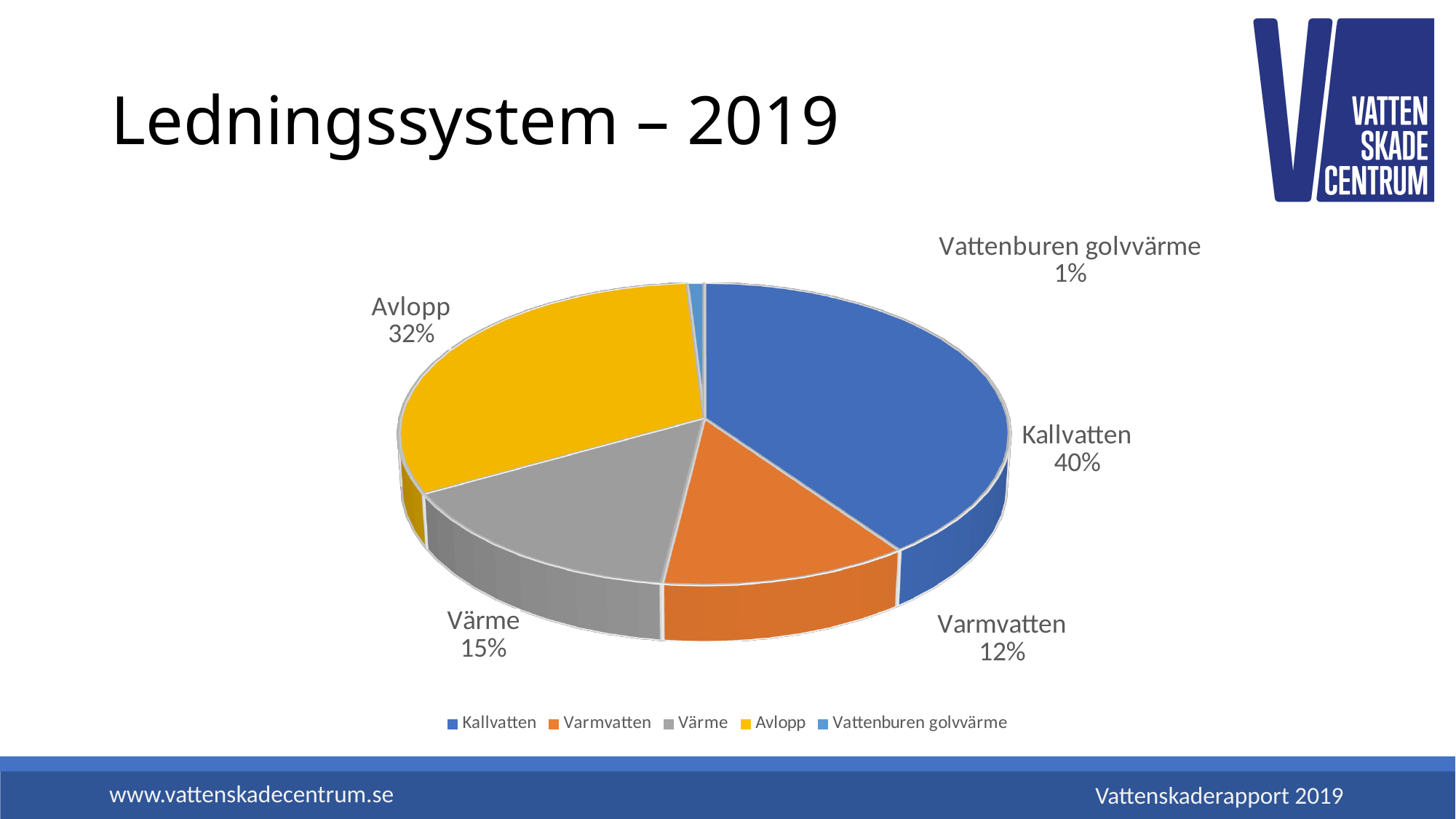
What percentage is shown for Avlopp? 32% How many categories are shown in the pie chart? 5 Which category has the smallest slice of the pie? Vattenburen golvvärme What is the difference in percentage points between Kallvatten and Avlopp? 8 Which category has the largest slice of the pie? Kallvatten What kind of chart is shown on the slide? Pie chart What share of the pie does Kallvatten represent? 40% What percentage is shown for Vattenburen golvvärme? 1% What colour is the Avlopp slice? Yellow What is the difference in percentage points between Värme and Varmvatten? 3 What is the value labelled for Värme? 15% Which is larger, the share for Varmvatten or the share for Värme? Värme